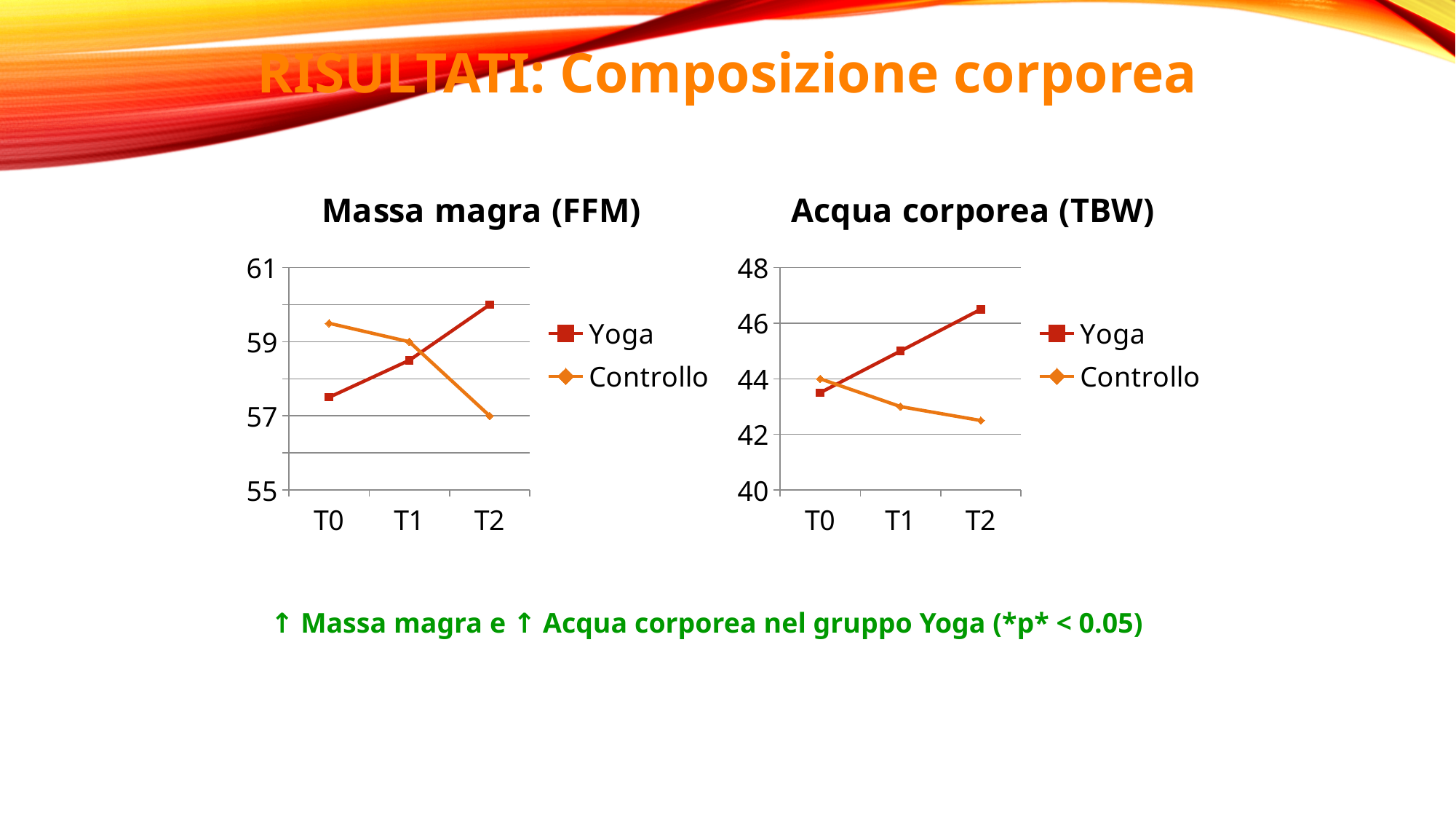
In the Massa magra (FFM) chart, is the value for Yoga at T0 greater or less than 57? greater In the Massa magra (FFM) chart, which series has the higher value at T2, Yoga or Controllo? Yoga In the Massa magra (FFM) chart, what is the value for Controllo at T1? 59 In the Acqua corporea (TBW) chart, what is the value for Controllo at T0? 44 What type of chart is the Massa magra (FFM) chart? Line chart In the Acqua corporea (TBW) chart, does the Yoga series rise or fall from T0 to T2? Rise In the Massa magra (FFM) chart, does the Controllo series rise or fall from T0 to T2? Fall How many time points are plotted on the x axis of the Massa magra (FFM) chart? 3 In the Acqua corporea (TBW) chart, is the value for Controllo at T2 greater or less than 44? less In the Acqua corporea (TBW) chart, is the value for Yoga at T2 greater or less than 46? greater How many series does the legend of the Acqua corporea (TBW) chart list? 2 In the Massa magra (FFM) chart, what is the value for Controllo at T2? 57